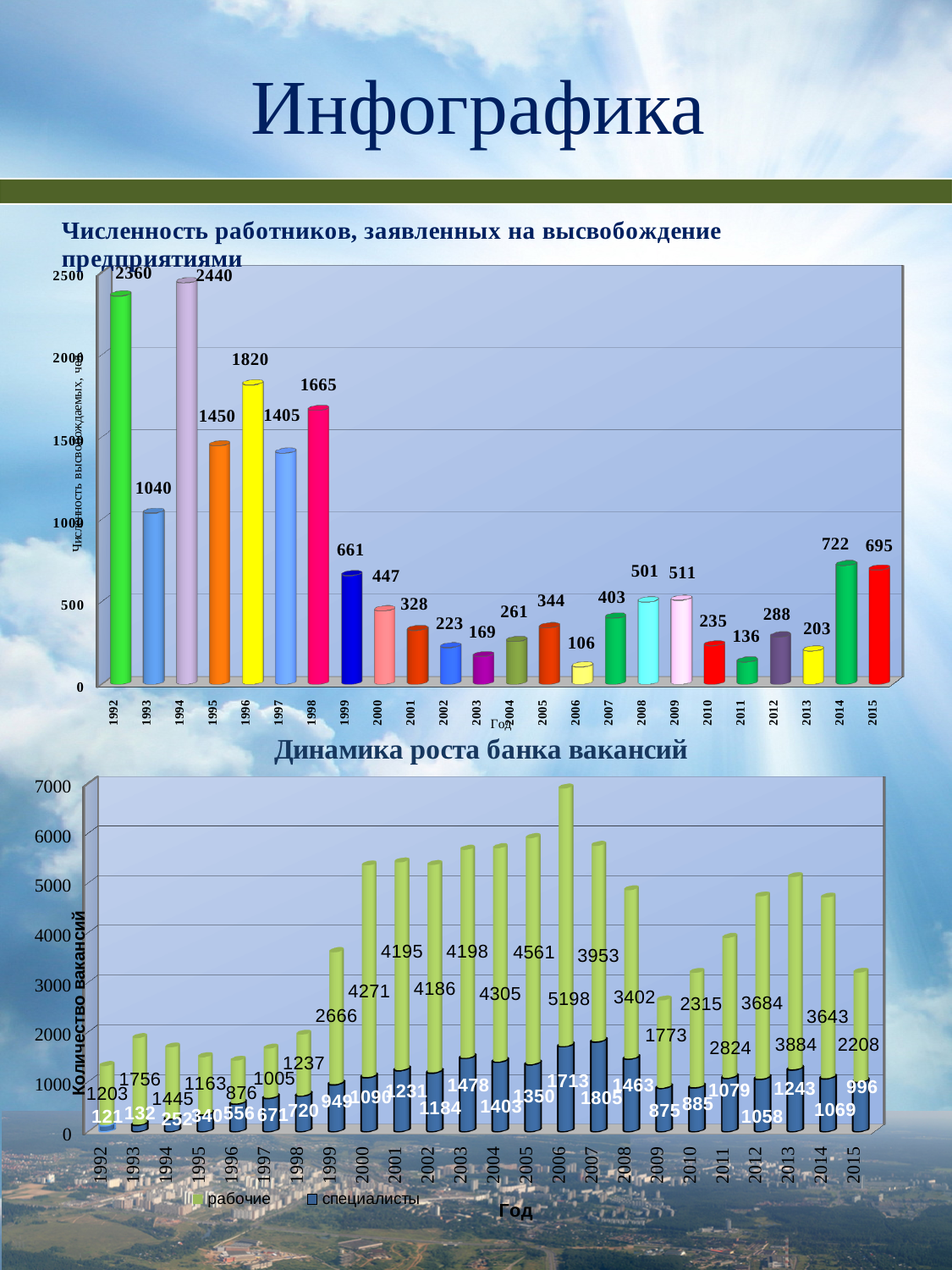
In the bottom chart (Динамика роста банка вакансий), what is the total of the stacked bar for 2006? 6911 In the top chart (Численность работников, заявленных на высвобождение предприятиями), what is the difference between the values for 2014 and 2015? 27 In the top chart (Численность работников, заявленных на высвобождение предприятиями), which year has the highest value? 1994 In the top chart (Численность работников, заявленных на высвобождение предприятиями), which year has the lowest value? 2006 What kind of chart is the bottom chart (Динамика роста банка вакансий)? Stacked bar chart How many series does the legend of the bottom chart (Динамика роста банка вакансий) list? 2 In the bottom chart (Динамика роста банка вакансий), what is the value of рабочие for 2006? 5198 In the bottom chart (Динамика роста банка вакансий), what is the value of специалисты for 2007? 1805 In the bottom chart (Динамика роста банка вакансий), which year has the highest value for рабочие? 2006 In the top chart (Численность работников, заявленных на высвобождение предприятиями), what is the value for 1994? 2440 In the top chart (Численность работников, заявленных на высвобождение предприятиями), which year has the larger value, 2008 or 2009? 2009 In the top chart (Численность работников, заявленных на высвобождение предприятиями), how many years are shown on the x axis? 24